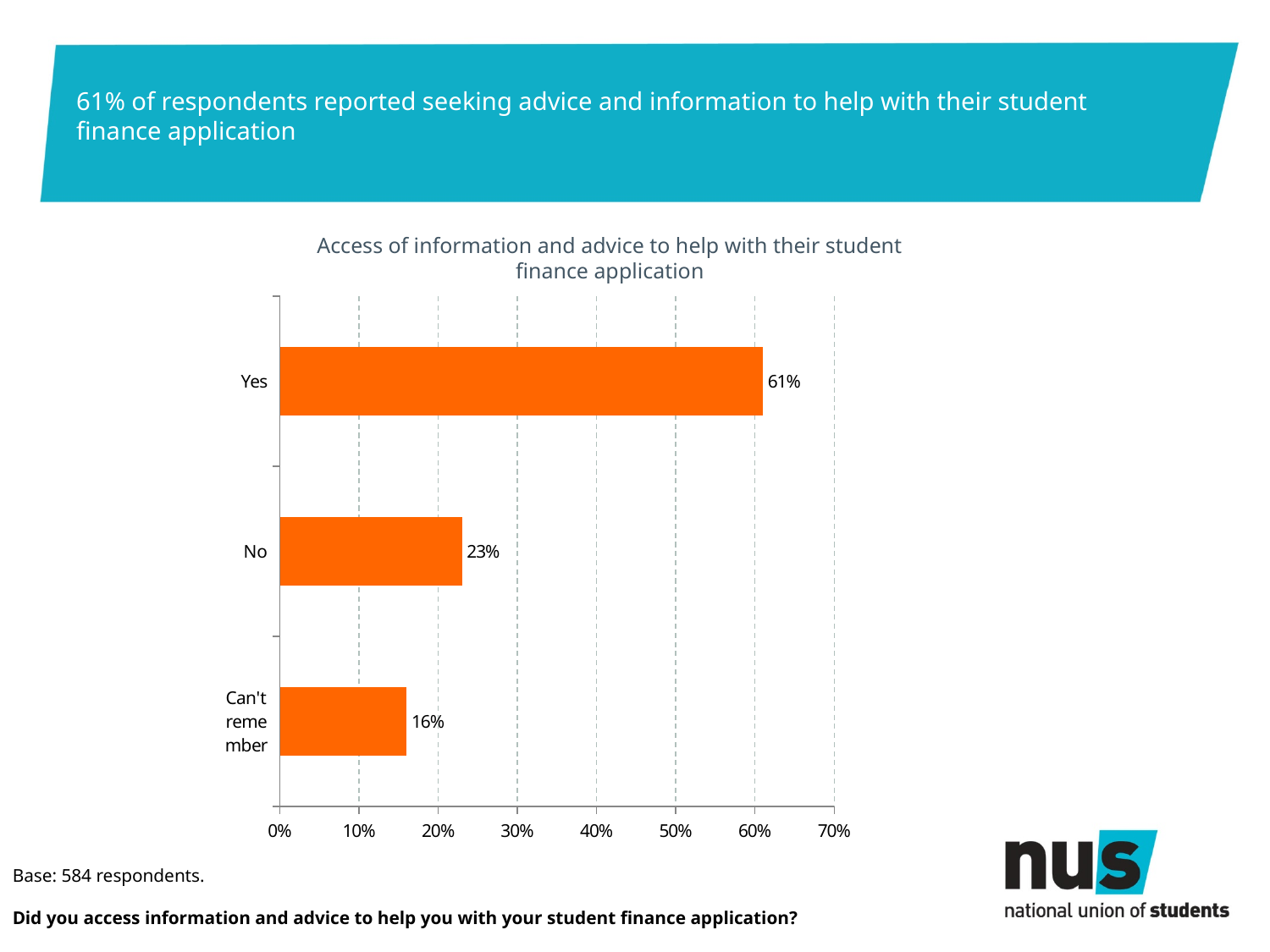
What percentage of respondents answered "Can't remember"? 16% How many response categories are shown in the chart? 3 What type of chart is shown on the slide? Bar chart Which is larger, the value for "No" or the value for "Can't remember"? No What is the difference between the "No" and "Can't remember" percentages? 7% What is the difference between the "Yes" and "No" percentages? 38% Which response category has the lowest value? Can't remember Which response category has the highest value? Yes What percentage of respondents answered "No"? 23% What is the title of the chart? Access of information and advice to help with their student finance application What percentage of respondents answered "Yes"? 61% Is the value for "Yes" greater or less than 50%? greater